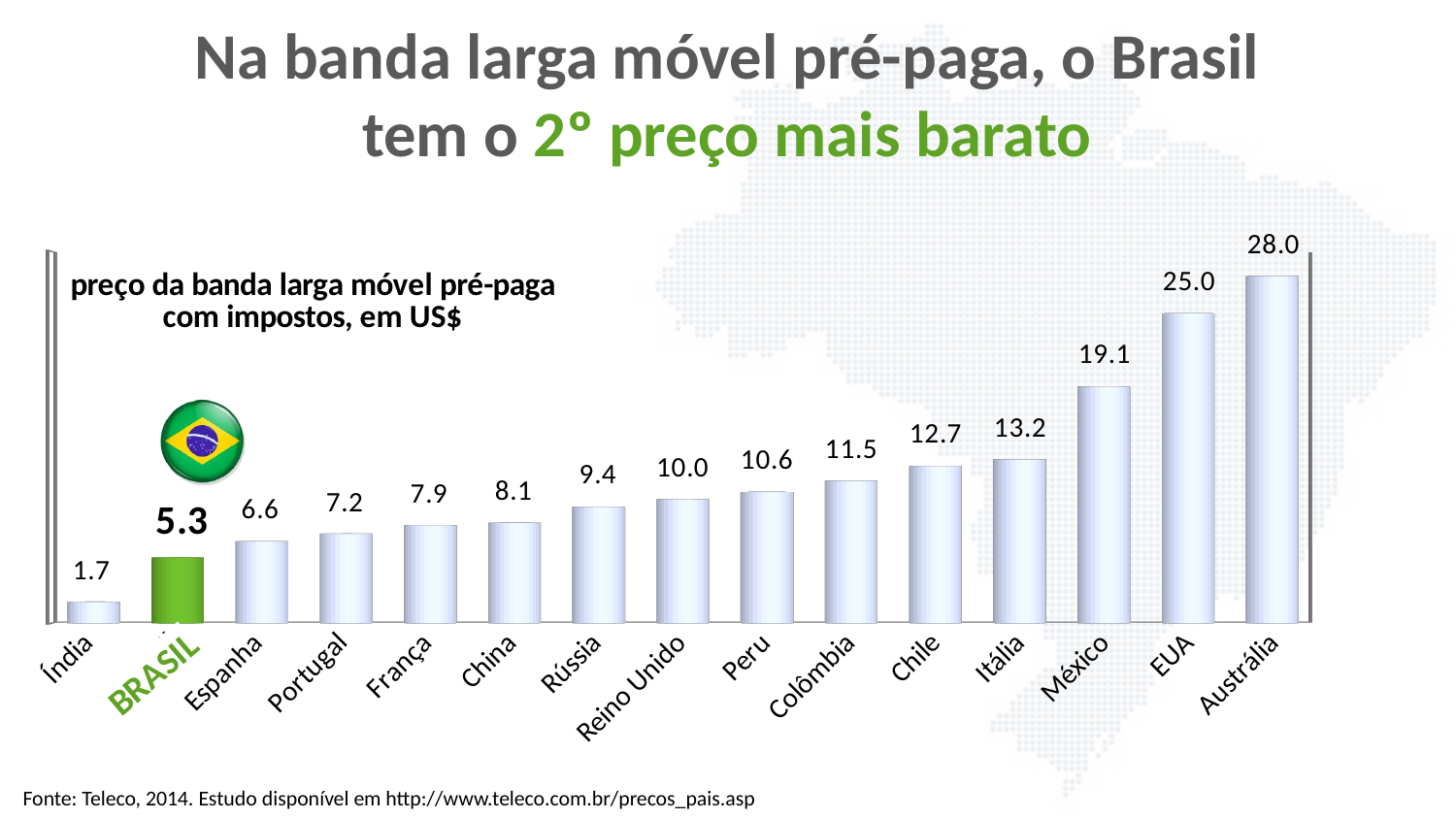
How many countries are shown in the chart? 15 What kind of chart is shown on the slide? bar chart Which country has the lowest price in the chart? Índia Which has a higher value, Chile or Itália? Itália Do the values rise or fall from left to right along the x axis? rise Which country has the highest price in the chart? Austrália Which bar is coloured green in the chart? BRASIL What is the difference between the values for EUA and México? 5.9 What is the prepaid mobile broadband price shown for BRASIL? 5.3 What is the difference between the values for Espanha and BRASIL? 1.3 What is the value shown for Reino Unido? 10.0 What is the value shown for Austrália? 28.0